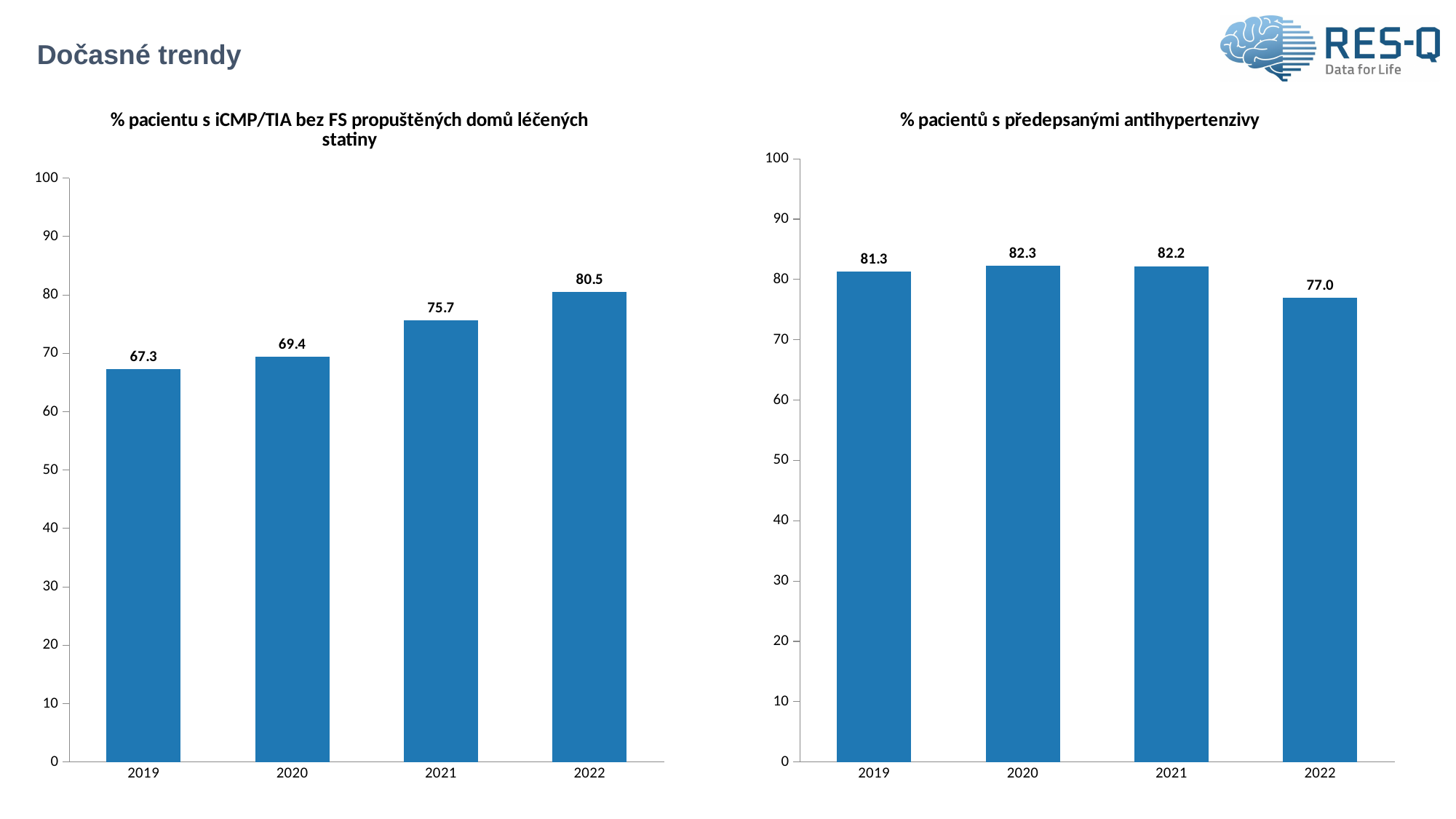
In the left chart (% pacientu s iCMP/TIA bez FS propuštěných domů léčených statiny), do the values rise or fall from 2019 to 2022? rise What type of chart is the left chart (% pacientu s iCMP/TIA bez FS propuštěných domů léčených statiny)? bar chart In the right chart (% pacientů s předepsanými antihypertenzivy), what is the value for 2020? 82.3 In the left chart (% pacientu s iCMP/TIA bez FS propuštěných domů léčených statiny), which year has the highest value? 2022 In the right chart (% pacientů s předepsanými antihypertenzivy), what is the difference between the 2021 and 2022 values? 5.2 In the right chart (% pacientů s předepsanými antihypertenzivy), what is the value for 2022? 77.0 In the left chart (% pacientu s iCMP/TIA bez FS propuštěných domů léčených statiny), which year has the lowest value? 2019 In the right chart (% pacientů s předepsanými antihypertenzivy), how many years are shown on the x axis? 4 In the left chart (% pacientu s iCMP/TIA bez FS propuštěných domů léčených statiny), what is the value for 2022? 80.5 In the left chart (% pacientu s iCMP/TIA bez FS propuštěných domů léčených statiny), what is the value for 2019? 67.3 In the left chart (% pacientu s iCMP/TIA bez FS propuštěných domů léčených statiny), what is the difference between the 2022 and 2019 values? 13.2 In the right chart (% pacientů s předepsanými antihypertenzivy), which year has the lowest value? 2022